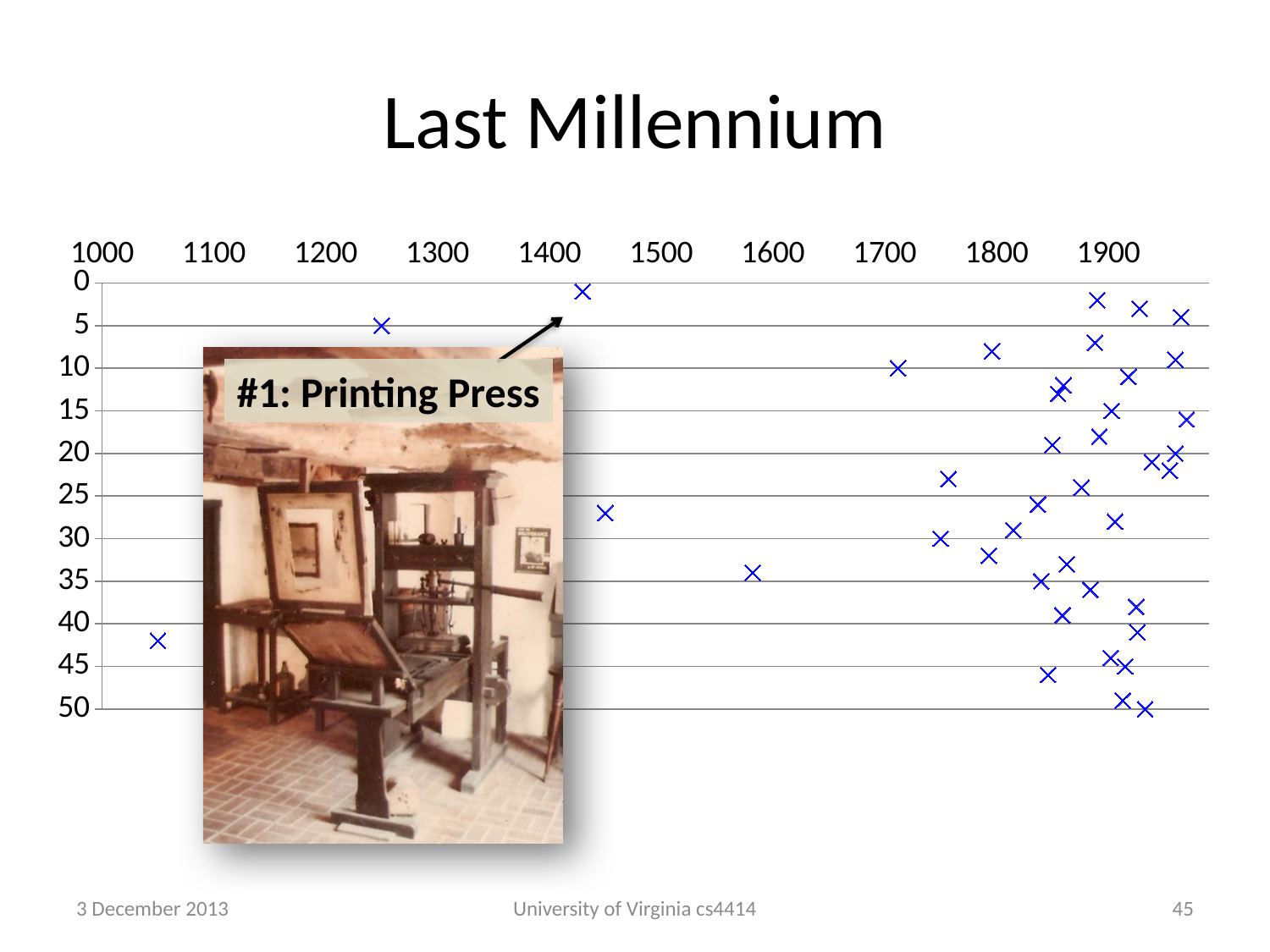
Is the y value of the point plotted near the year 1050 greater or less than 30? greater Is the y value of the point plotted near the year 1450 greater or less than 25? greater Are there more points plotted before the year 1500 or after the year 1800? after 1800 What is the highest year label shown on the x axis? 1900 What is the lowest year label shown on the x axis? 1000 Is the y value of the point plotted near the year 1580 greater or less than 30? greater Which invention is labelled #1 on the chart? Printing Press What is the title of the chart? Last Millennium What kind of chart is shown on the slide? scatter chart What is the largest value labelled on the y axis? 50